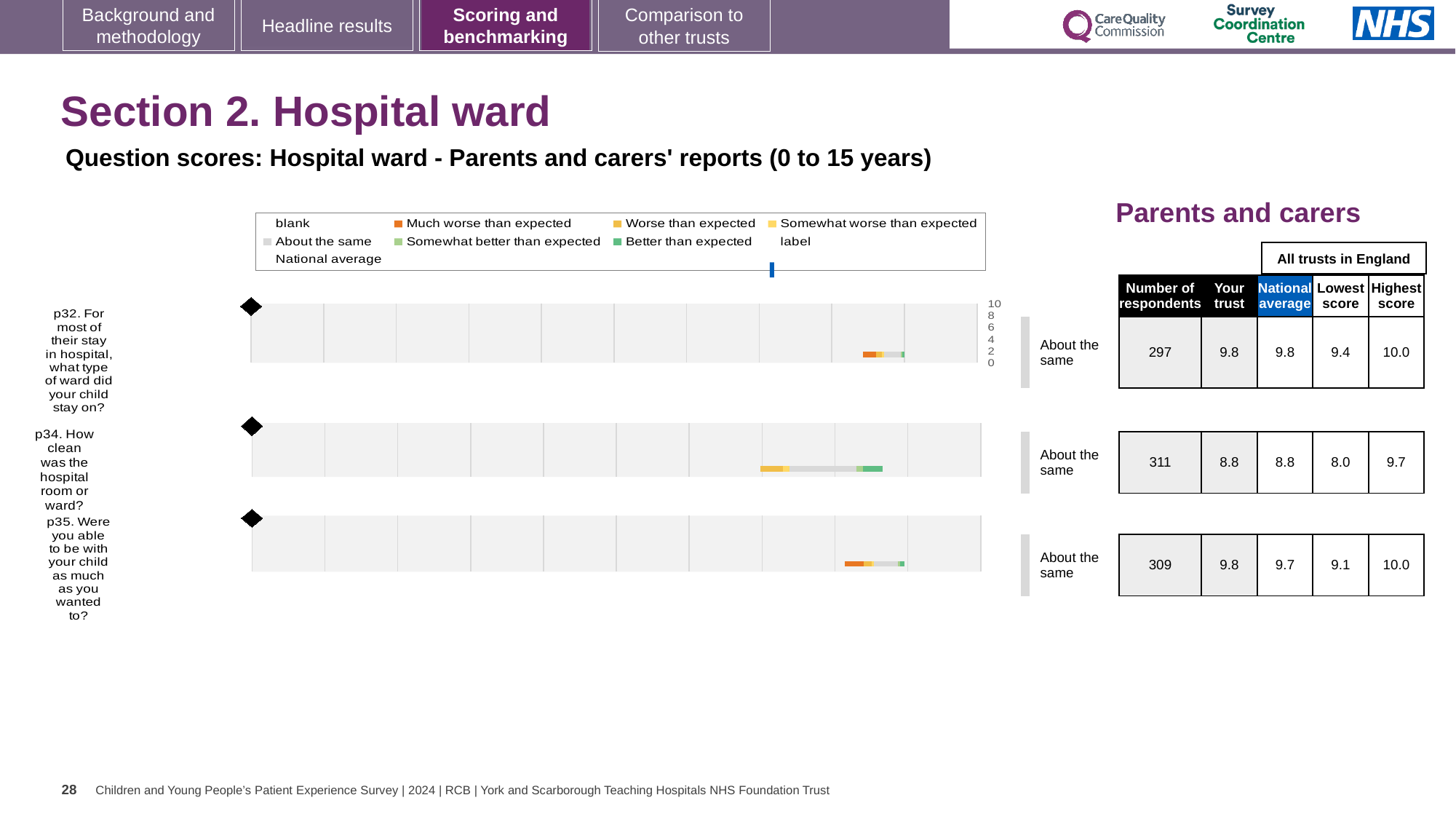
What is the 'Your trust' score for p34 (How clean was the hospital room or ward?)? 8.8 How many respondents answered p32 (For most of their stay in hospital, what type of ward did your child stay on?)? 297 Which question has the lowest 'Your trust' score on this slide? p34 What kind of chart is used to show the question scores? bar chart What is the difference between the highest score and the lowest score for p34? 1.7 What is the lowest score among all trusts in England for p34? 8.0 Which has the larger 'Your trust' score, p32 or p34? p32 Which question has the highest number of respondents? p34 What is the highest score among all trusts in England for p35 (Were you able to be with your child as much as you wanted to?)? 10.0 How many questions are charted on this slide? 3 What is the national average score for p35? 9.7 What benchmark category is shown next to the chart for p35? About the same